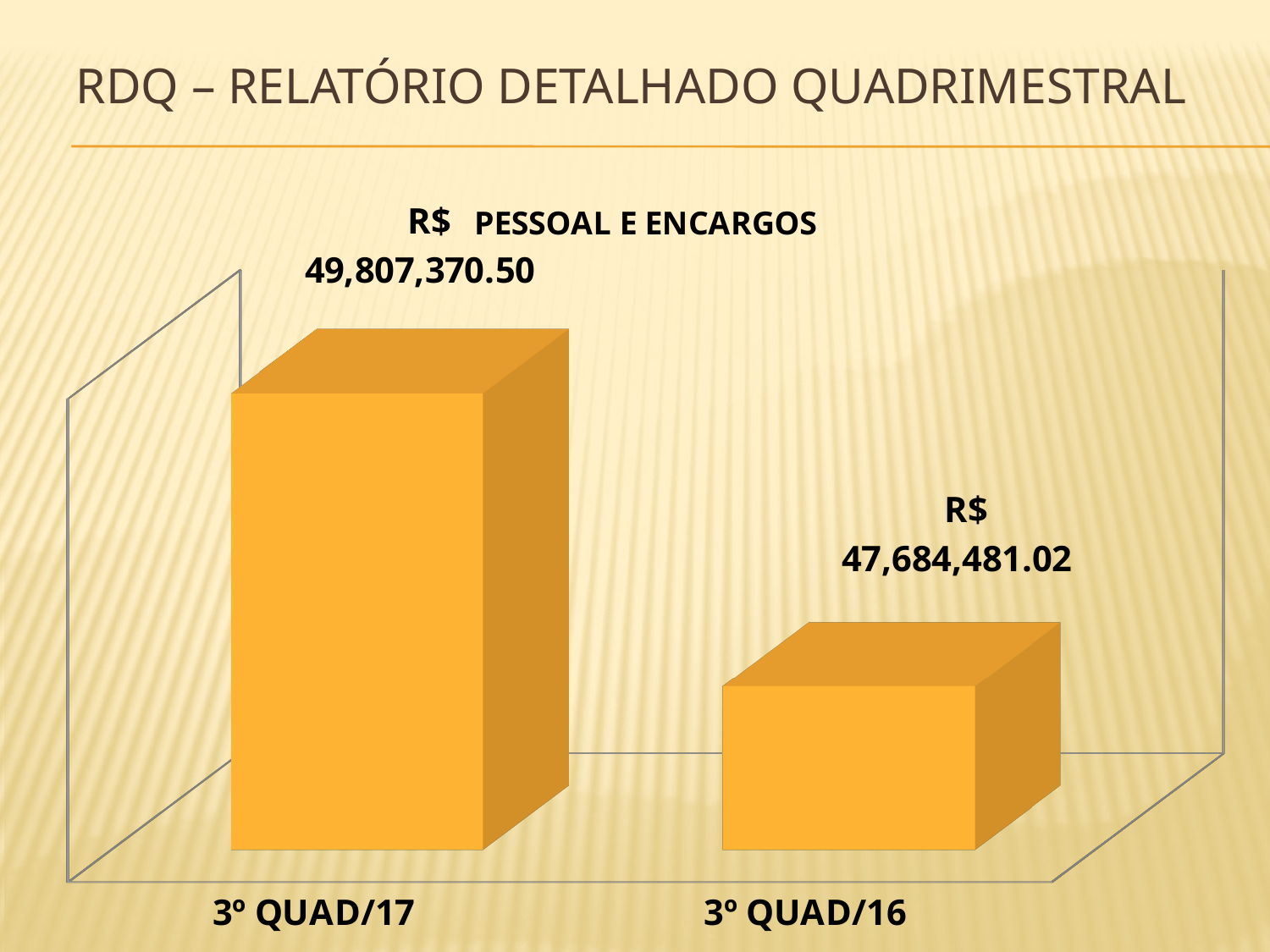
Which category has the lowest value in the chart? 3º QUAD/16 Do the values rise or fall from left to right along the x axis? Fall What is the value for 3º QUAD/17 in the PESSOAL E ENCARGOS chart? R$ 49,807,370.50 Which category has the highest value in the chart? 3º QUAD/17 Which is larger, the value for 3º QUAD/17 or the value for 3º QUAD/16? 3º QUAD/17 What is the title of the chart? PESSOAL E ENCARGOS What is the value for 3º QUAD/16 in the PESSOAL E ENCARGOS chart? R$ 47,684,481.02 How many categories are shown in the chart? 2 What colour are the bars in the chart? Orange What kind of chart is shown on the slide? Bar chart What is the difference between the values for 3º QUAD/17 and 3º QUAD/16? R$ 2,122,889.48